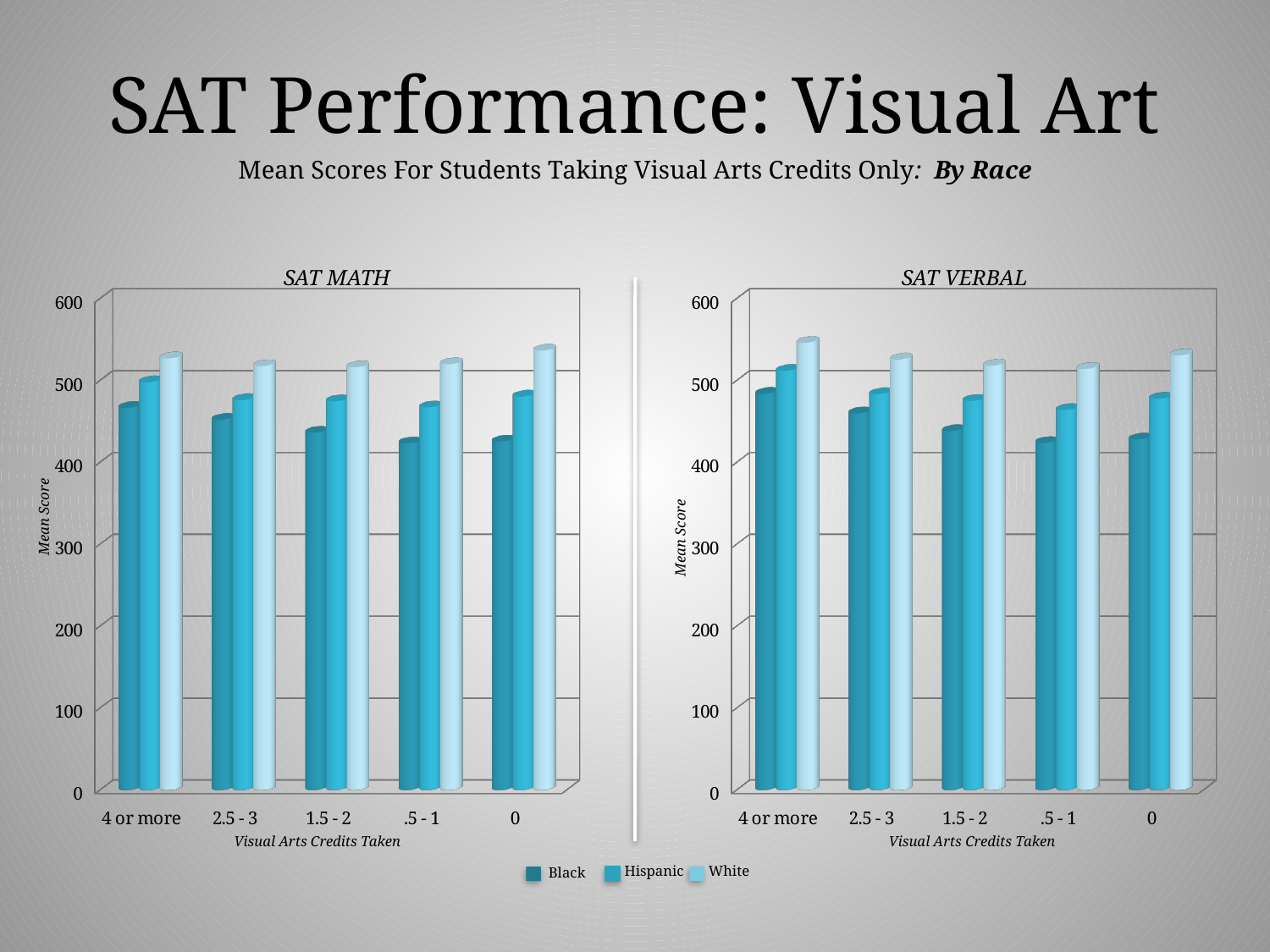
In the SAT MATH chart, is the value for Black students with .5 - 1 credits greater or less than 500? less In the SAT MATH chart, which series has the highest bar in every credit category? White What is the label on the x axis of the SAT MATH chart? Visual Arts Credits Taken How many categories are shown on the x axis of the SAT VERBAL chart? 5 What kind of chart is the SAT MATH chart? bar chart What is the label on the y axis of the SAT VERBAL chart? Mean Score In the SAT VERBAL chart, is the value for Black students with 0 credits greater or less than 500? less In the SAT VERBAL chart, which credit category has the highest value for Black students? 4 or more In the SAT MATH chart, which is larger: the value for Black students with 4 or more credits or with 1.5 - 2 credits? 4 or more In the SAT MATH chart, is the value for White students with 4 or more credits greater or less than 500? greater How many series does the legend list? 3